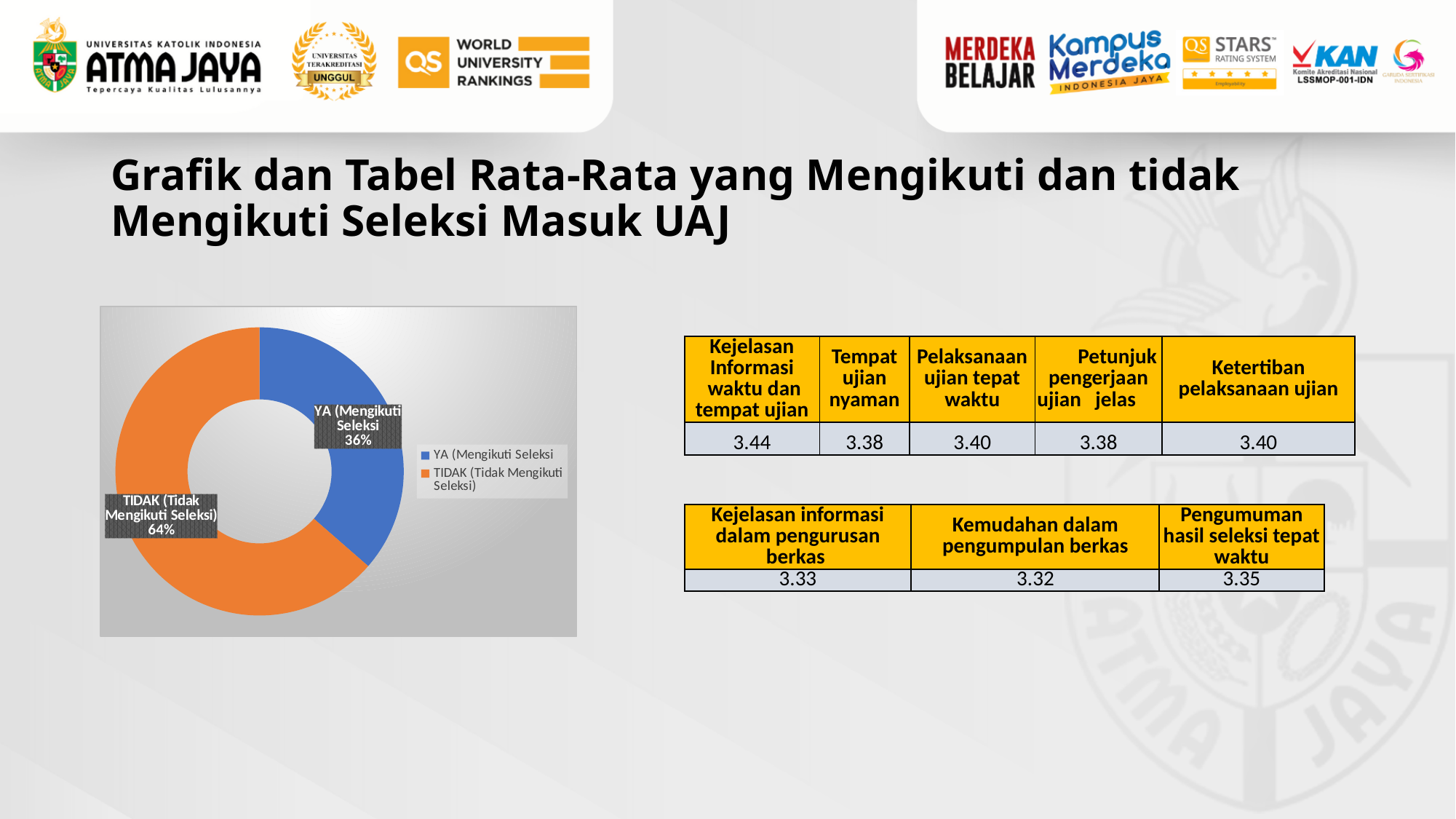
What type of chart is shown on the left of the slide? Doughnut chart What colour is the TIDAK (Tidak Mengikuti Seleksi) slice in the doughnut chart? Orange Which slice of the doughnut chart is the smallest? YA (Mengikuti Seleksi) What share of the doughnut chart does the TIDAK (Tidak Mengikuti Seleksi) slice represent? 64% What colour is the YA (Mengikuti Seleksi) slice in the doughnut chart? Blue How many slices does the doughnut chart have? 2 What percentage of the doughnut chart is labelled TIDAK (Tidak Mengikuti Seleksi)? 64% How many entries does the legend of the doughnut chart list? 2 Which is larger in the doughnut chart: YA (Mengikuti Seleksi) or TIDAK (Tidak Mengikuti Seleksi)? TIDAK (Tidak Mengikuti Seleksi) Which slice of the doughnut chart is the largest? TIDAK (Tidak Mengikuti Seleksi) What is the difference in percentage points between the TIDAK (Tidak Mengikuti Seleksi) slice and the YA (Mengikuti Seleksi) slice? 28 What percentage of the doughnut chart is labelled YA (Mengikuti Seleksi)? 36%